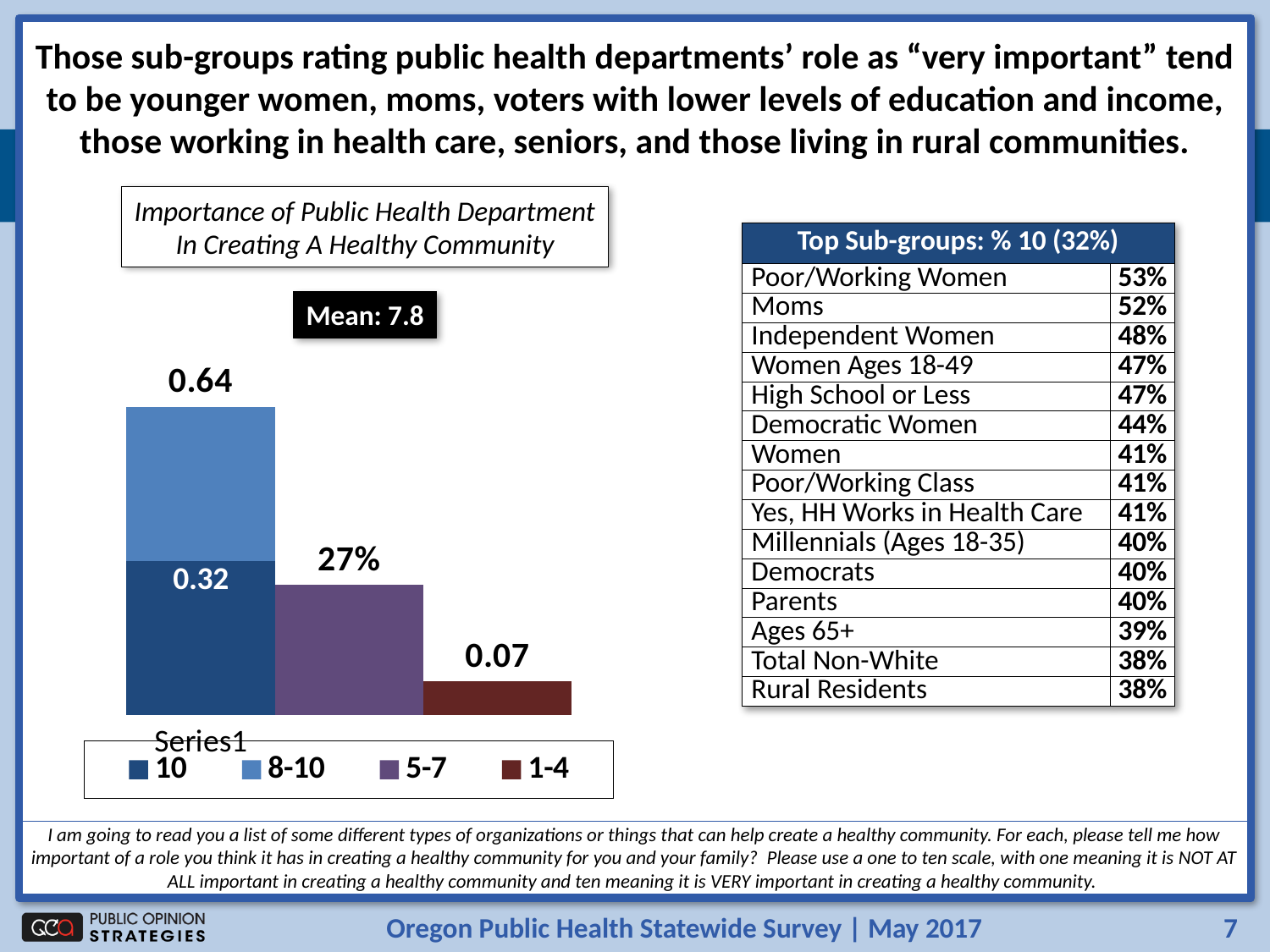
What is the value labelled for the 10 series? 0.32 What mean value is shown in the box above the chart? Mean: 7.8 What is the value labelled for the 5-7 series? 27% Which series has the lowest labelled value? 1-4 Which series has the highest labelled value? 8-10 What is the title of the chart? Importance of Public Health Department In Creating A Healthy Community Which is larger, the value for 10 or the value for 1-4? 10 What kind of chart is shown on the slide? bar chart What is the difference between the value for 8-10 and the value for 10? 0.32 What is the value labelled for the 8-10 series? 0.64 What is the value labelled for the 1-4 series? 0.07 How many series does the chart's legend list? 4